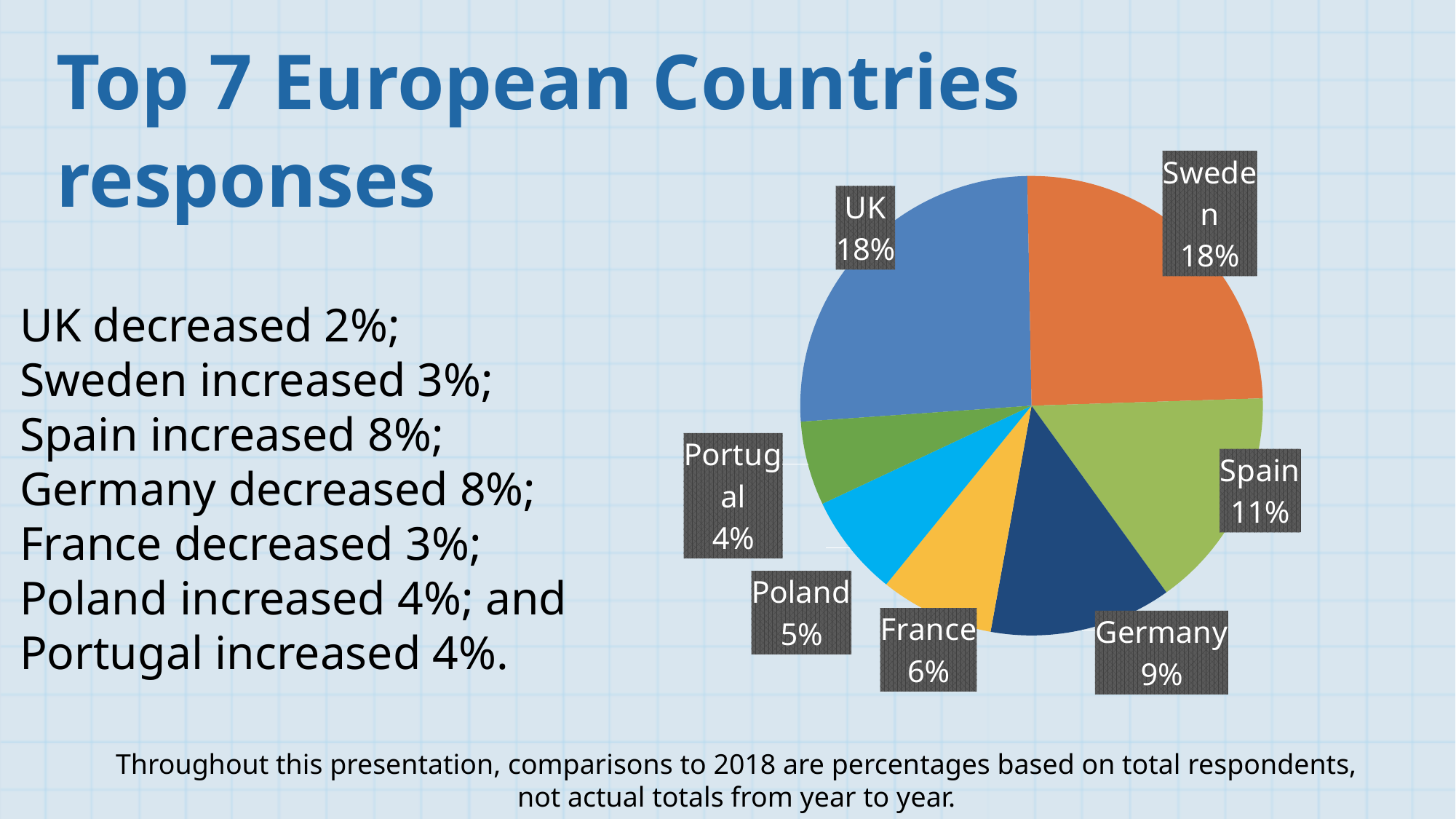
Which has a larger share in the pie chart, Spain or Germany? Spain What percentage of responses does the pie chart show for Sweden? 18% What percentage of responses does the pie chart show for Poland? 5% Which country has the smallest slice in the pie chart? Portugal Which has a larger share in the pie chart, France or Poland? France What is the difference between the percentages shown for Spain and Germany? 2% What is the difference between the percentages shown for UK and France? 12% What type of chart is shown on the slide? Pie chart How many countries are shown as slices in the pie chart? 7 What is the title of the slide containing the pie chart? Top 7 European Countries responses What percentage of responses does the pie chart show for Germany? 9% What percentage of responses does the pie chart show for Spain? 11%